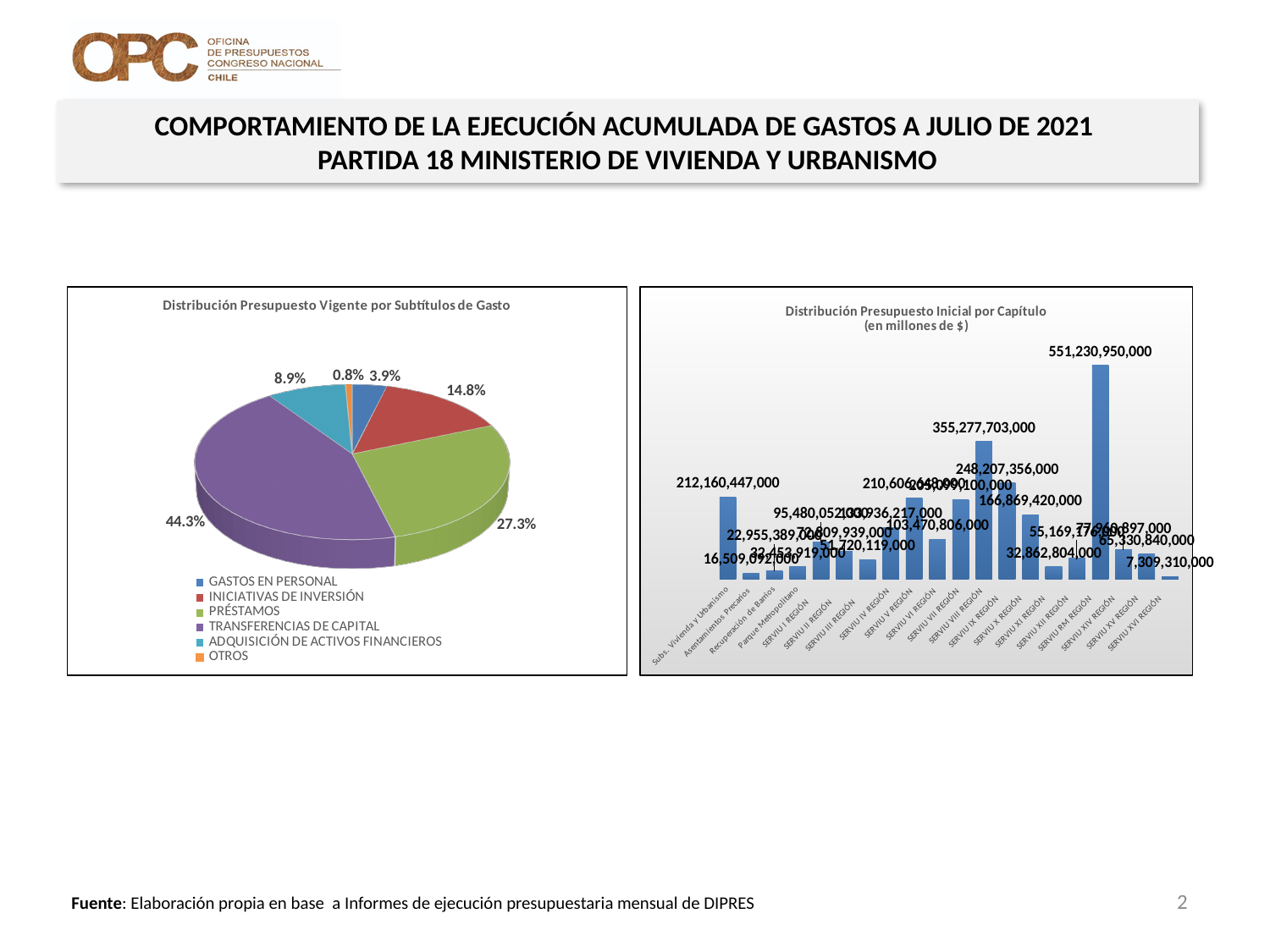
How many categories does the legend of the left pie chart list? 6 In the right bar chart, what is the value for SERVIU RM REGIÓN? 551,230,950,000 In the right bar chart, which capítulo has the lowest value? SERVIU XVI REGIÓN In the left pie chart, what share does INICIATIVAS DE INVERSIÓN have? 14.8% In the left pie chart, which category has the largest share? TRANSFERENCIAS DE CAPITAL In the right bar chart, what is the value for Subs. Vivienda y Urbanismo? 212,160,447,000 In the left pie chart, what share does PRÉSTAMOS have? 27.3% In the left pie chart, which category has the smallest share? OTROS In the left pie chart, what share does TRANSFERENCIAS DE CAPITAL have? 44.3% In the right bar chart, which capítulo has the highest value? SERVIU RM REGIÓN In the right chart, 'Distribución Presupuesto Inicial por Capítulo', what kind of chart is shown? Bar chart In the left chart, 'Distribución Presupuesto Vigente por Subtítulos de Gasto', what kind of chart is shown? Pie chart